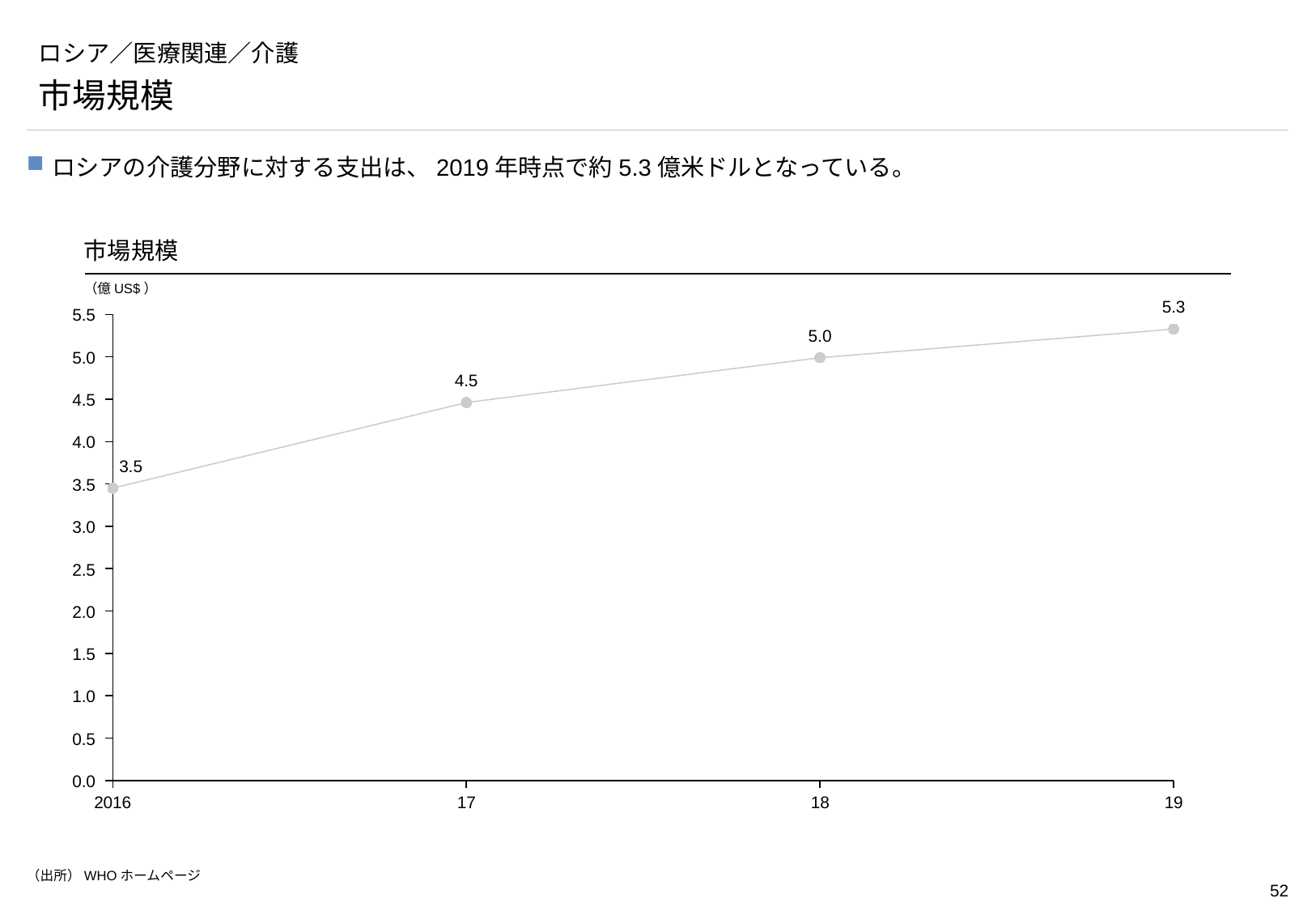
How many data points are plotted on the chart? 4 Which year has the highest market size? 2019 Is the value for 2016 greater or less than 4.0? less What is the market size value for 2017? 4.5 What kind of chart is shown on the slide? line chart What is the market size value for 2016? 3.5 What is the market size value for 2018? 5.0 Which year has the lowest market size? 2016 What is the market size value for 2019? 5.3 Which is larger, the market size in 2017 or in 2018? 2018 What is the difference between the market size in 2019 and in 2016? 1.8 Do the values rise or fall from 2016 to 2019? rise